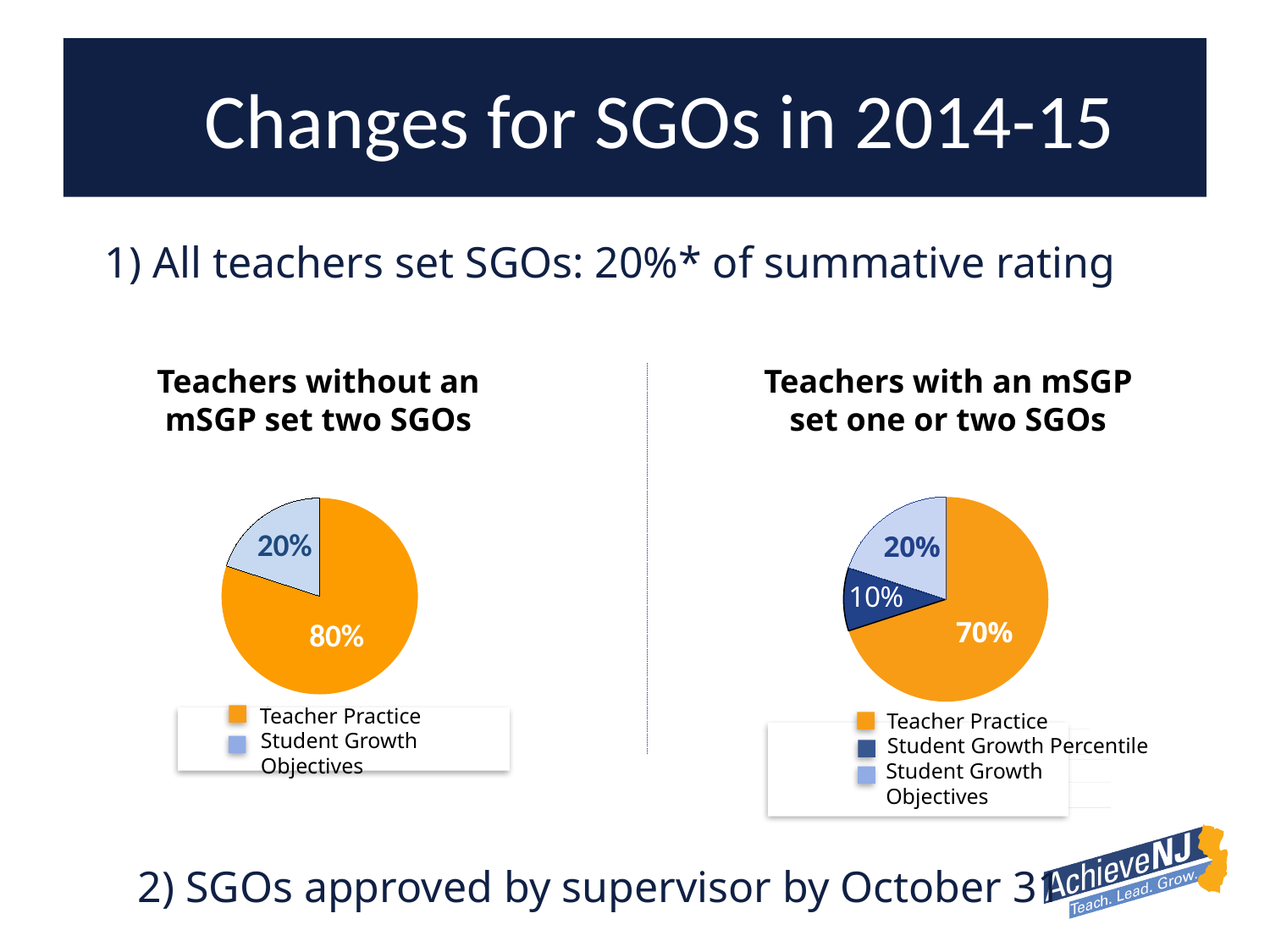
In the 'Teachers without an mSGP set two SGOs' chart, what is the difference between the Teacher Practice and Student Growth Objectives shares? 60% What kind of chart is the 'Teachers without an mSGP set two SGOs' chart? Pie chart In the 'Teachers with an mSGP set one or two SGOs' chart, which is larger: Student Growth Percentile or Student Growth Objectives? Student Growth Objectives In the 'Teachers with an mSGP set one or two SGOs' chart, which slice is the smallest? Student Growth Percentile In the 'Teachers with an mSGP set one or two SGOs' chart, what share does Student Growth Percentile have? 10% In the 'Teachers without an mSGP set two SGOs' chart, what share does Student Growth Objectives have? 20% In the 'Teachers with an mSGP set one or two SGOs' chart, which slice is the largest? Teacher Practice In the 'Teachers with an mSGP set one or two SGOs' chart, what share does Teacher Practice have? 70% How many entries does the legend of the 'Teachers without an mSGP set two SGOs' chart list? 2 In the 'Teachers without an mSGP set two SGOs' chart, what share does Teacher Practice have? 80% In the 'Teachers with an mSGP set one or two SGOs' chart, what share does Student Growth Objectives have? 20% How many slices does the 'Teachers with an mSGP set one or two SGOs' chart have? 3